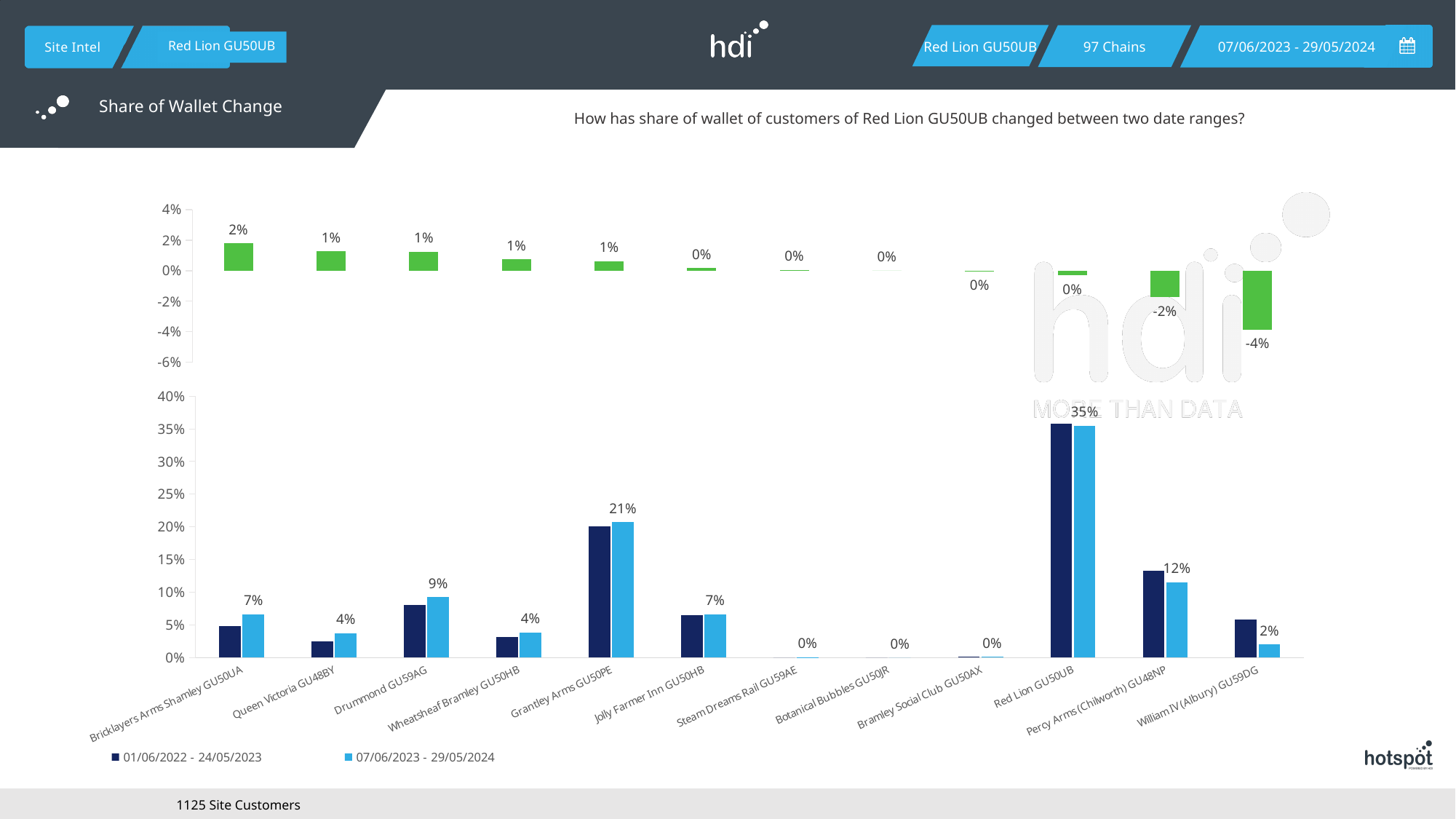
On the bottom chart, what is the difference between the 07/06/2023 - 29/05/2024 values for Grantley Arms GU50PE and Drummond GU59AG? 12% On the top chart, what is the share of wallet change for Bricklayers Arms Shamley GU50UA? 2% On the bottom chart, which site has the highest share of wallet in the 07/06/2023 - 29/05/2024 period? Red Lion GU50UB How many sites are shown on the x axis of the bottom chart? 12 On the bottom chart, which has the larger 07/06/2023 - 29/05/2024 share of wallet: Percy Arms (Chilworth) GU48NP or Jolly Farmer Inn GU50HB? Percy Arms (Chilworth) GU48NP What are the two legend entries on the bottom chart? 01/06/2022 - 24/05/2023 and 07/06/2023 - 29/05/2024 On the bottom chart, is the 01/06/2022 - 24/05/2023 value for Grantley Arms GU50PE greater or less than 15%? greater On the top chart, which site has the lowest share of wallet change? William IV (Albury) GU59DG What kind of chart is the bottom chart? bar chart On the top chart, what is the share of wallet change for Percy Arms (Chilworth) GU48NP? -2% On the bottom chart, what is the 07/06/2023 - 29/05/2024 share of wallet for Red Lion GU50UB? 35% How many series does the legend of the bottom chart list? 2